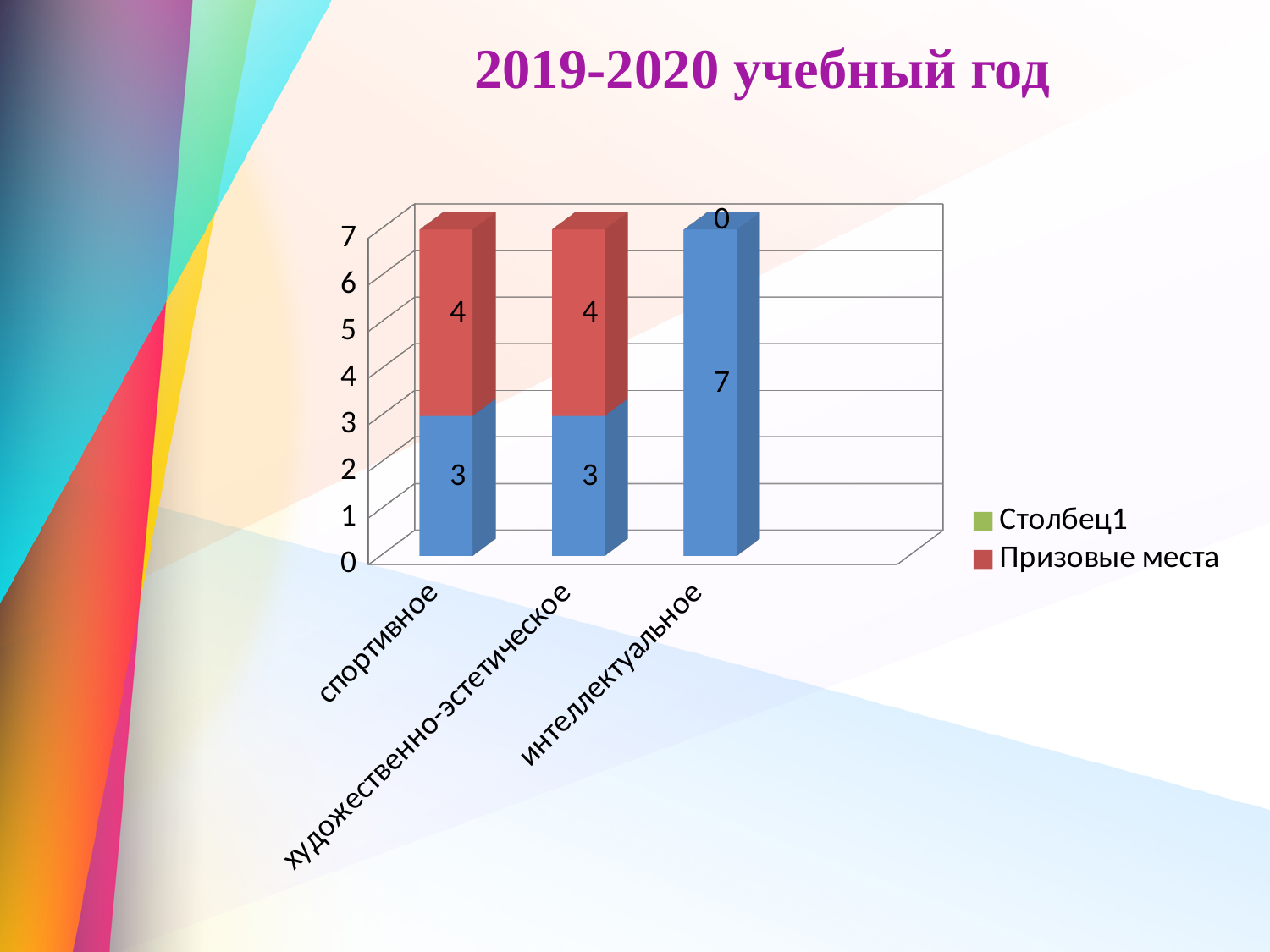
What is the title of the slide with the chart? 2019-2020 учебный год What is the difference between the blue segment for интеллектуальное and the blue segment for спортивное? 4 Which category has the highest value for the blue segment? интеллектуальное How many categories are shown on the x axis of the chart? 3 What is the value of Призовые места for интеллектуальное? 0 Which category has the lowest value for Призовые места? интеллектуальное What is the value of the blue segment for художественно-эстетическое? 3 What is the value of Призовые места for спортивное? 4 How many entries does the chart legend list? 2 What is the value of the blue segment for интеллектуальное? 7 What is the total of the stacked bar for спортивное? 7 What type of chart is shown on the slide? bar chart